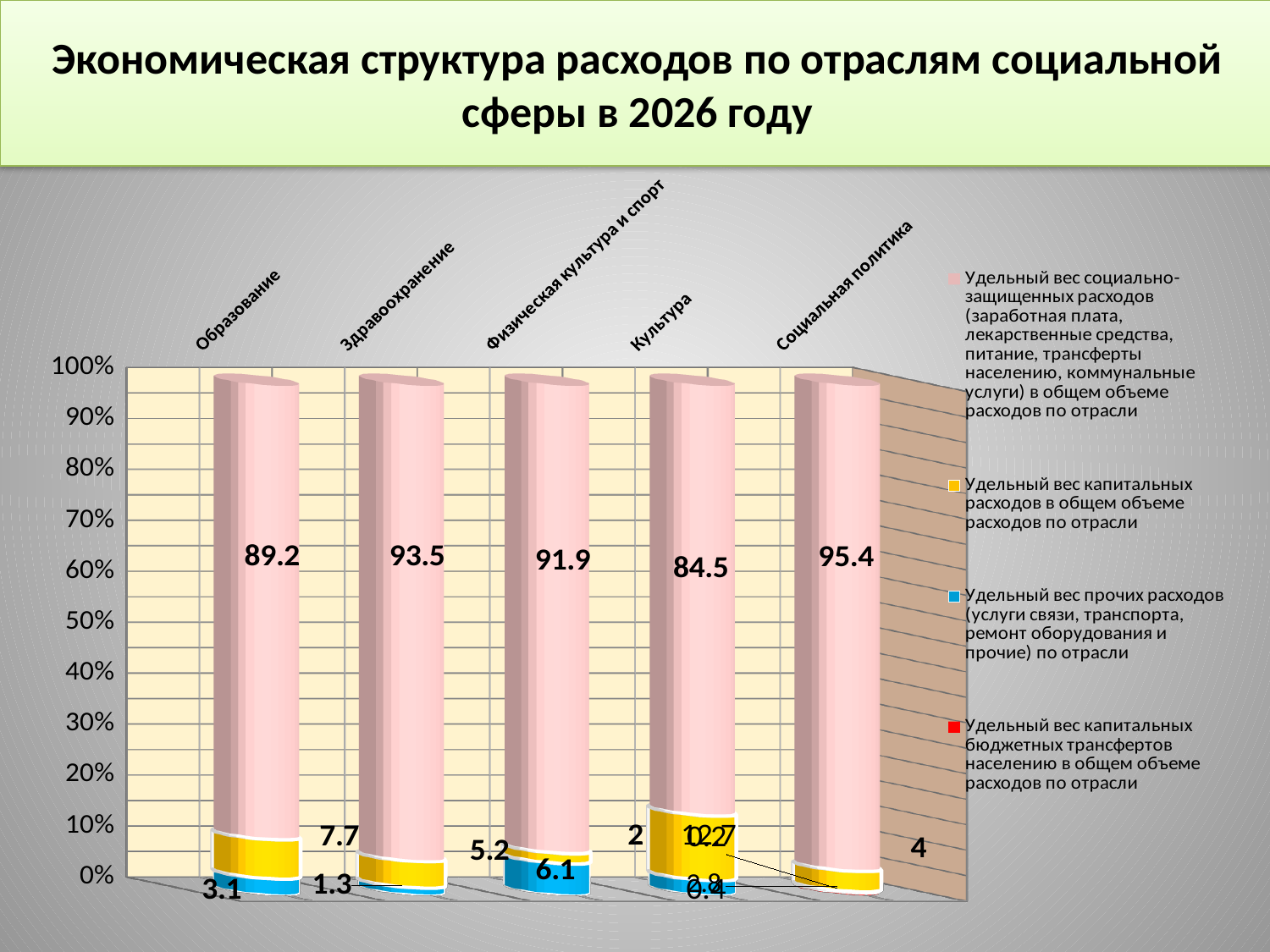
What is the difference between the pink series values for Социальная политика and Культура? 10.9 Which category has the highest value for the socially protected expenditure share (pink series)? Социальная политика How many series does the legend list? 4 What is the value of the socially protected expenditure share (pink series) for Культура? 84.5 What is the value of the other expenditure share (blue series) for Физическая культура и спорт? 6.1 What kind of chart is shown on the slide? Stacked bar chart What is the value of the socially protected expenditure share (pink series) for Образование? 89.2 What is the value of the socially protected expenditure share (pink series) for Здравоохранение? 93.5 Which category has the lowest value for the socially protected expenditure share (pink series)? Культура Which is larger: the pink series value for Физическая культура и спорт or for Здравоохранение? Здравоохранение How many categories (industries) are shown on the chart? 5 What is the value of the capital expenditure share (yellow series) for Образование? 7.7